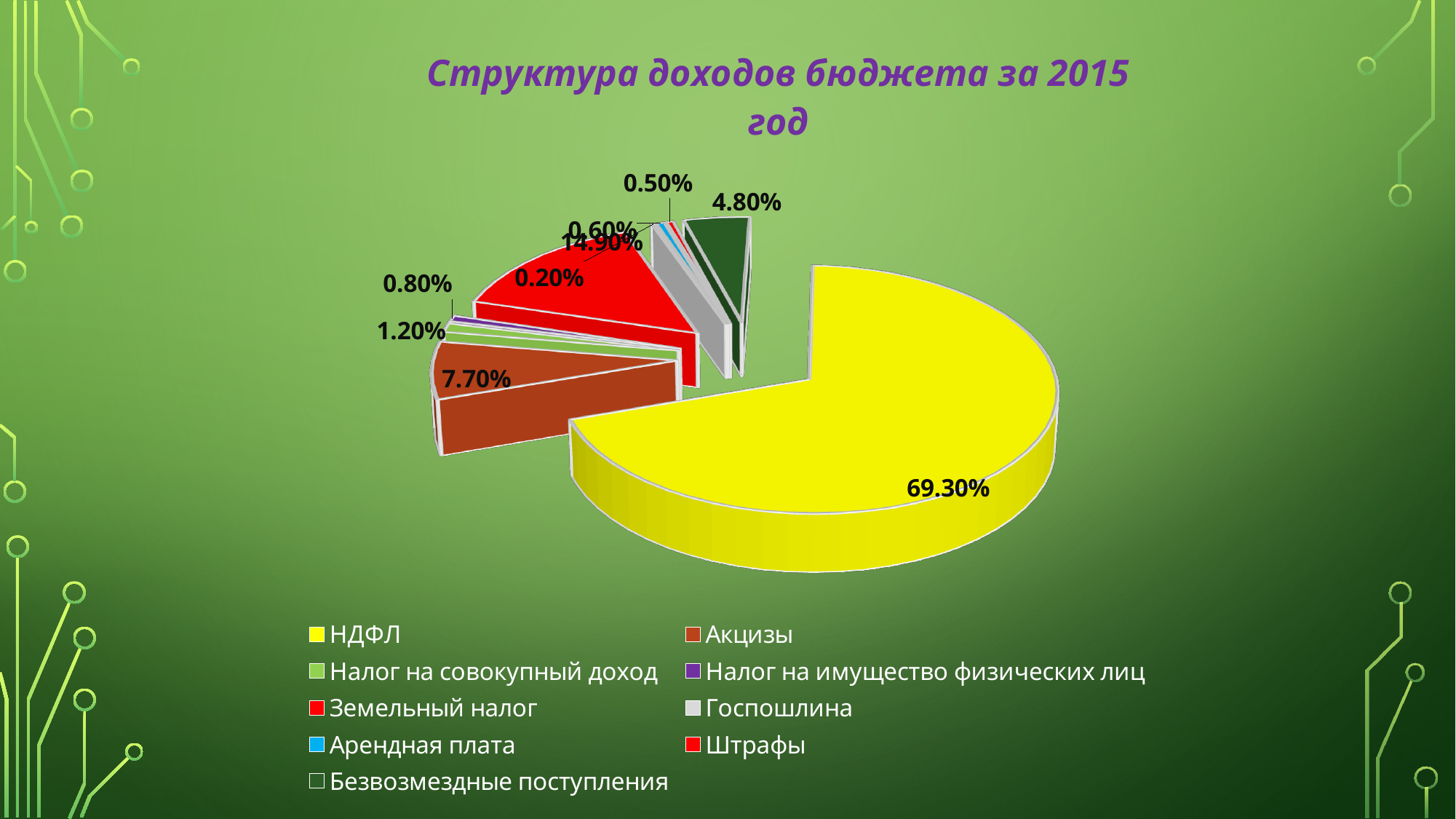
What is the value shown for Безвозмездные поступления? 4.80% Which category has the largest share of the pie? НДФЛ What is the title of the chart? Структура доходов бюджета за 2015 год What is the difference in percentage points between the share for НДФЛ and the share for Земельный налог? 54.40 How many categories does the legend list? 9 What kind of chart is shown on the slide? Pie chart What is the value shown for Налог на совокупный доход? 1.20% What colour is the slice for НДФЛ? Yellow What share of the pie does НДФЛ account for? 69.30% What is the value shown for Земельный налог? 14.90% What is the value shown for Акцизы? 7.70% Which is larger, the share for Акцизы or the share for Земельный налог? Земельный налог